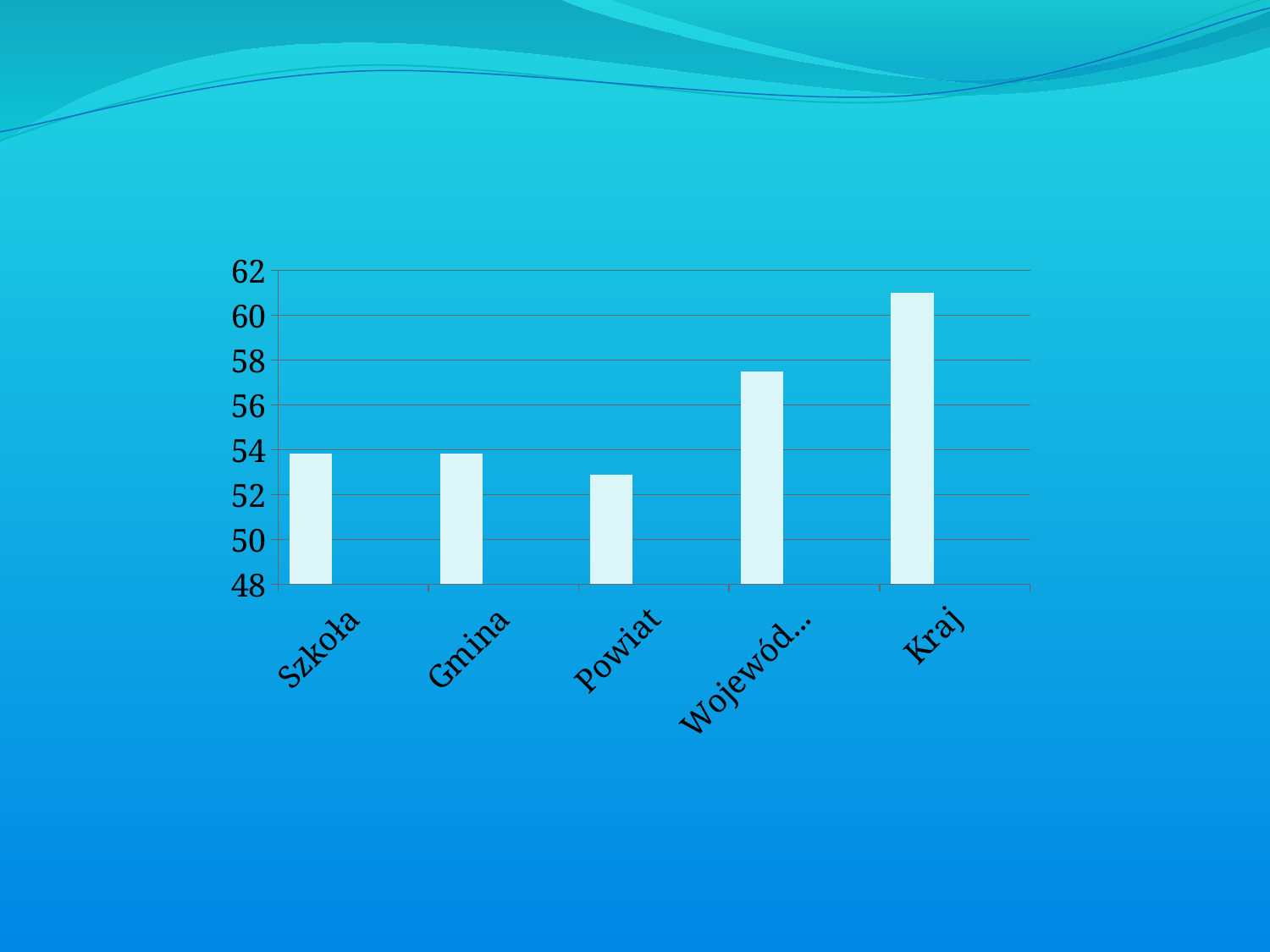
Which is larger, the value for Szkoła or the value for Wojewód...? Wojewód... How many categories are shown on the x axis of the chart? 5 Is the value for Szkoła greater or less than 52? greater Is the value for Powiat greater or less than 54? less Is the value for Wojewód... greater or less than 56? greater What is the lowest value shown on the vertical axis of the chart? 48 Which is larger, the value for Kraj or the value for Powiat? Kraj What kind of chart is shown on the slide? bar chart Which category has the highest bar in the chart? Kraj Which category has the lowest bar in the chart? Powiat